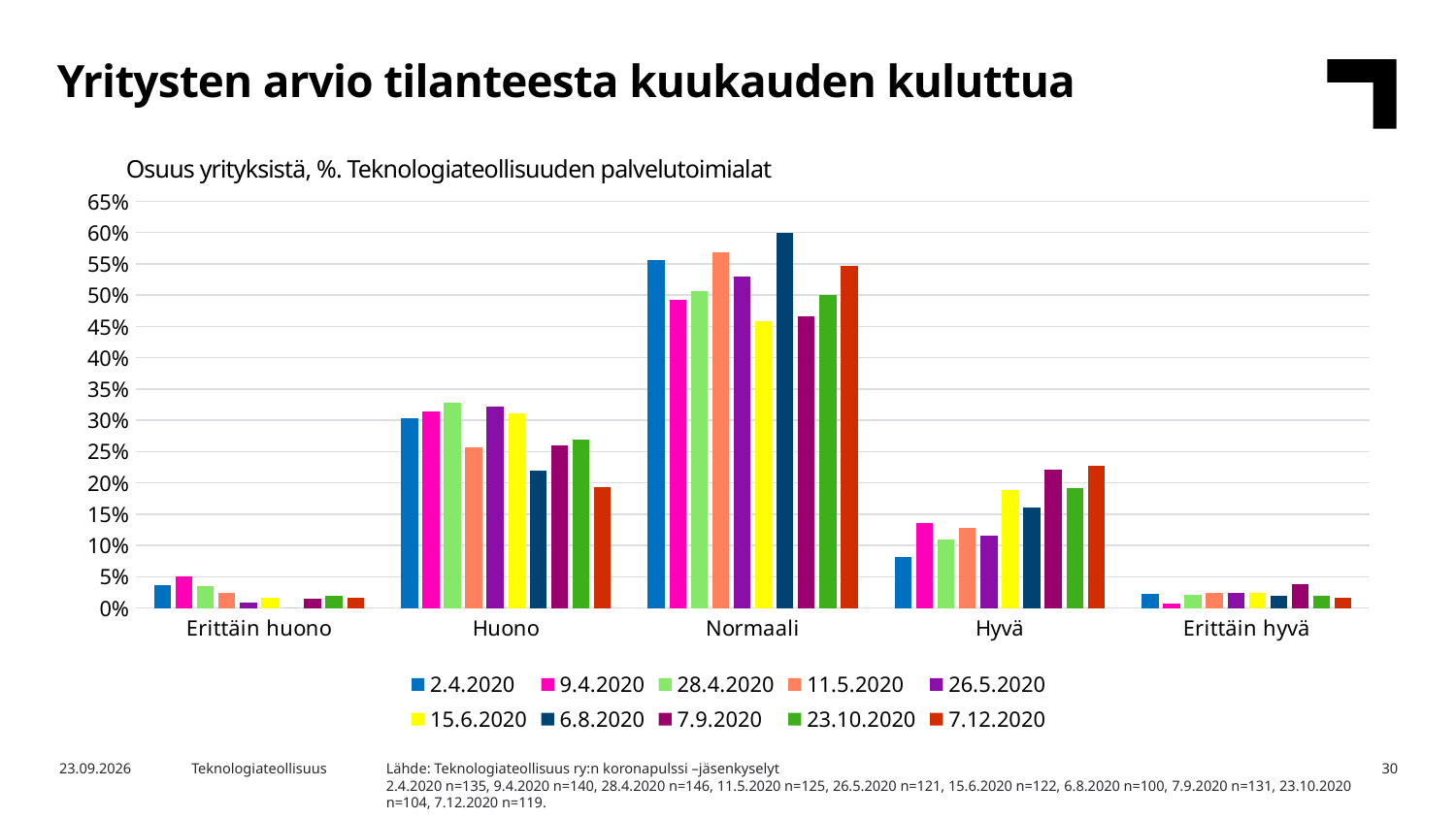
Is the value for 7.12.2020 in the Huono category greater or less than 25%? less How many categories are shown on the x axis of the chart? 5 What kind of chart is shown on the slide? Bar chart Which category has the highest value for the 6.8.2020 series? Normaali How many series does the chart legend list? 10 Is the value for 15.6.2020 in the Normaali category greater or less than 50%? less What is the subtitle printed above the chart? Osuus yrityksistä, %. Teknologiateollisuuden palvelutoimialat Which category has the lowest value for the 9.4.2020 series? Erittäin hyvä Is the value for 6.8.2020 in the Normaali category greater or less than 55%? greater In the Huono category, which is larger: the value for 28.4.2020 or the value for 6.8.2020? 28.4.2020 In the Hyvä category, which is larger: the value for 7.12.2020 or the value for 2.4.2020? 7.12.2020